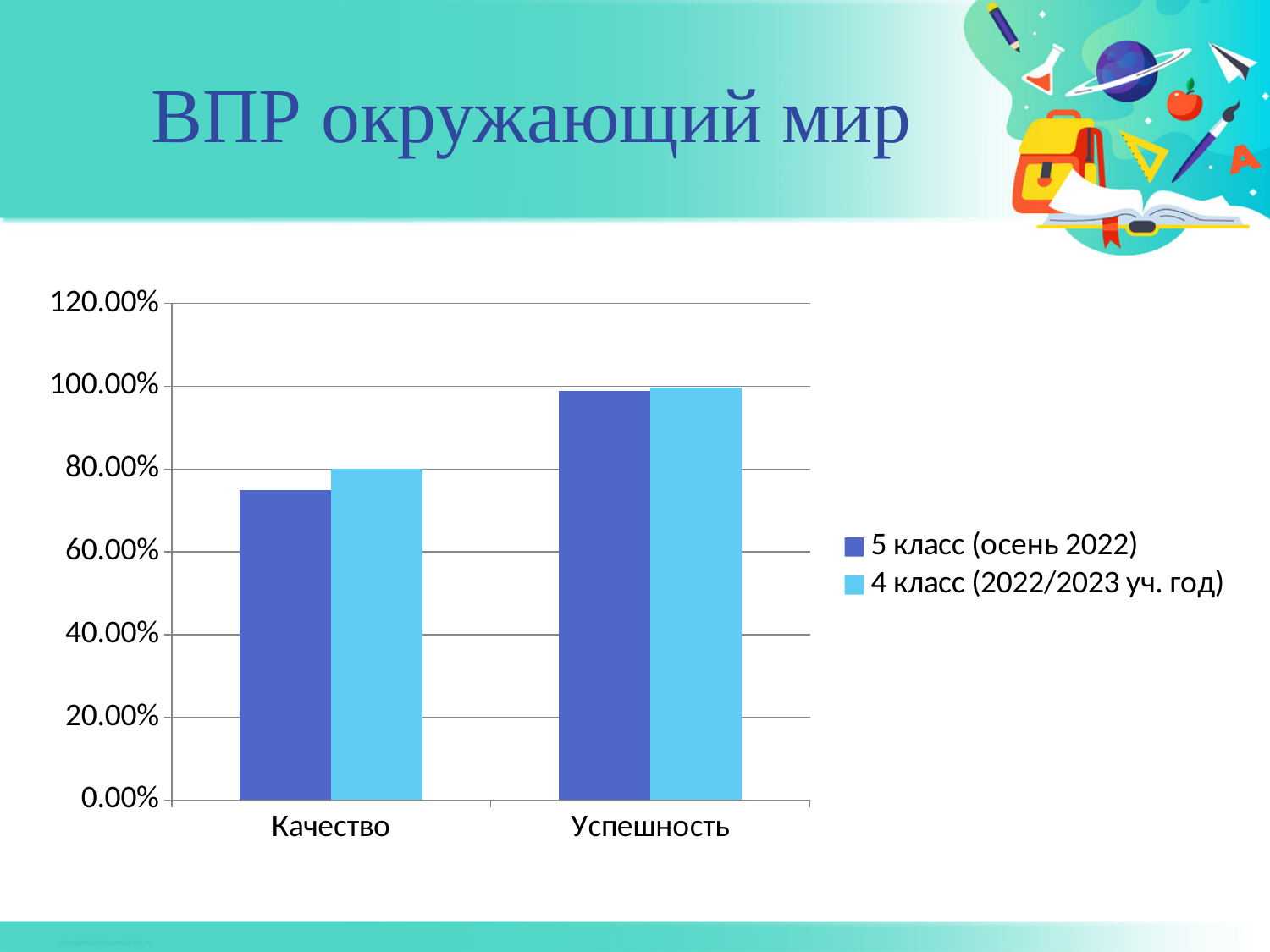
Which category has the highest value in the series 5 класс (осень 2022)? Успешность What are the two categories on the x axis of the chart? Качество, Успешность How many series does the chart legend list? 2 How many categories are shown on the x axis of the chart? 2 What is the title of the slide containing the chart? ВПР окружающий мир For the category Качество, which series has the larger value: 5 класс (осень 2022) or 4 класс (2022/2023 уч. год)? 4 класс (2022/2023 уч. год) Which category has the lowest value in the series 4 класс (2022/2023 уч. год)? Качество What kind of chart is shown on the slide? bar chart Is the value for Качество in the series 5 класс (осень 2022) greater or less than 80.00%? less Is the value for Качество in the series 5 класс (осень 2022) greater or less than 60.00%? greater Is the value for Успешность in the series 5 класс (осень 2022) greater or less than 80.00%? greater